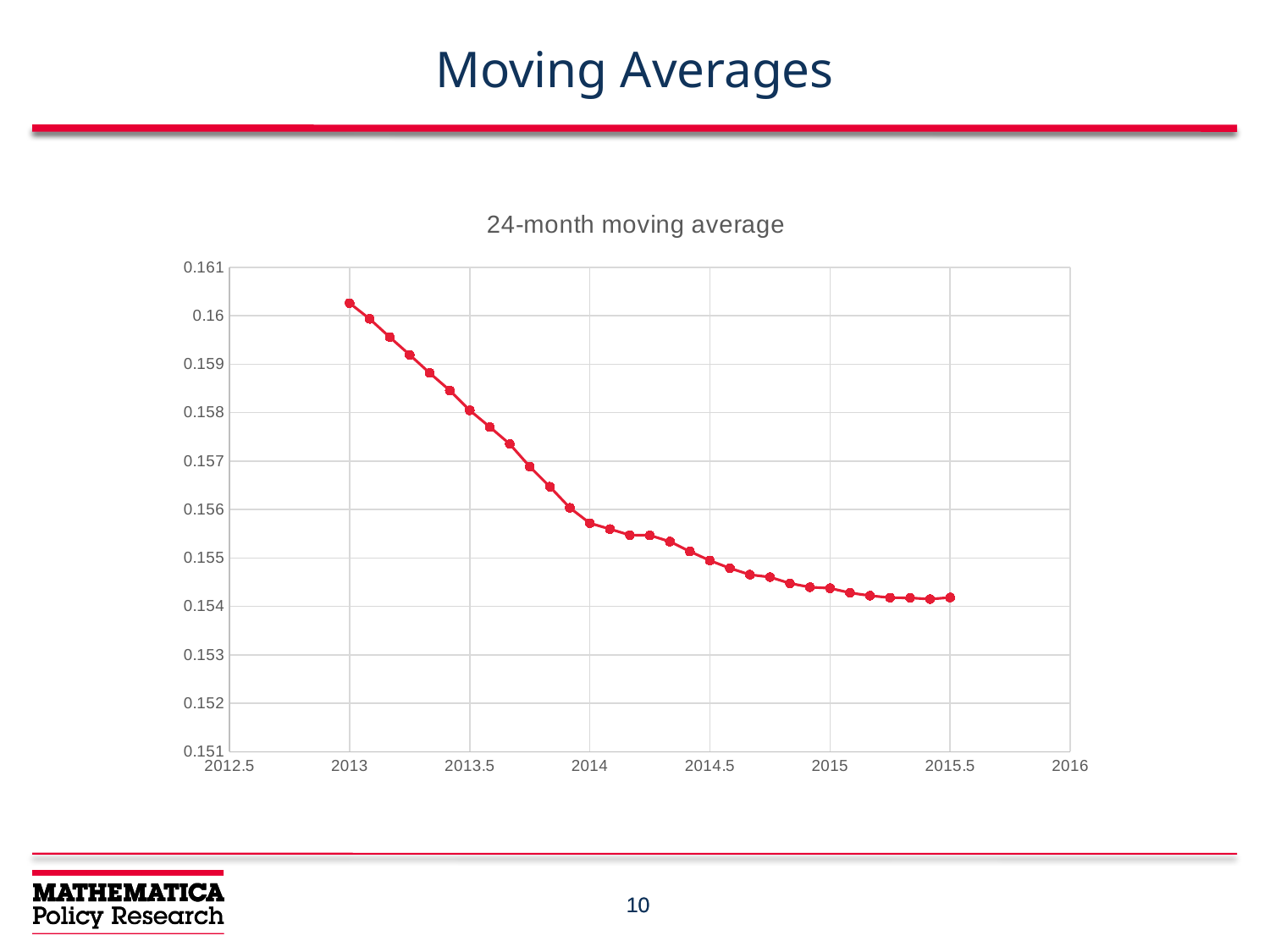
What colour is the plotted line? red Is the value at 2015.5 greater or less than 0.154? greater Is the value at 2014 greater or less than 0.155? greater At which x-axis value is the plotted value highest? 2013 Is the value at 2014 greater or less than 0.156? less Do the values rise or fall as the x axis moves from 2013 to 2015.5? fall What is the title of the chart? 24-month moving average What kind of chart is shown on the slide? line chart Which is larger, the value at 2013 or the value at 2015.5? 2013 Which is larger, the value at 2014 or the value at 2015? 2014